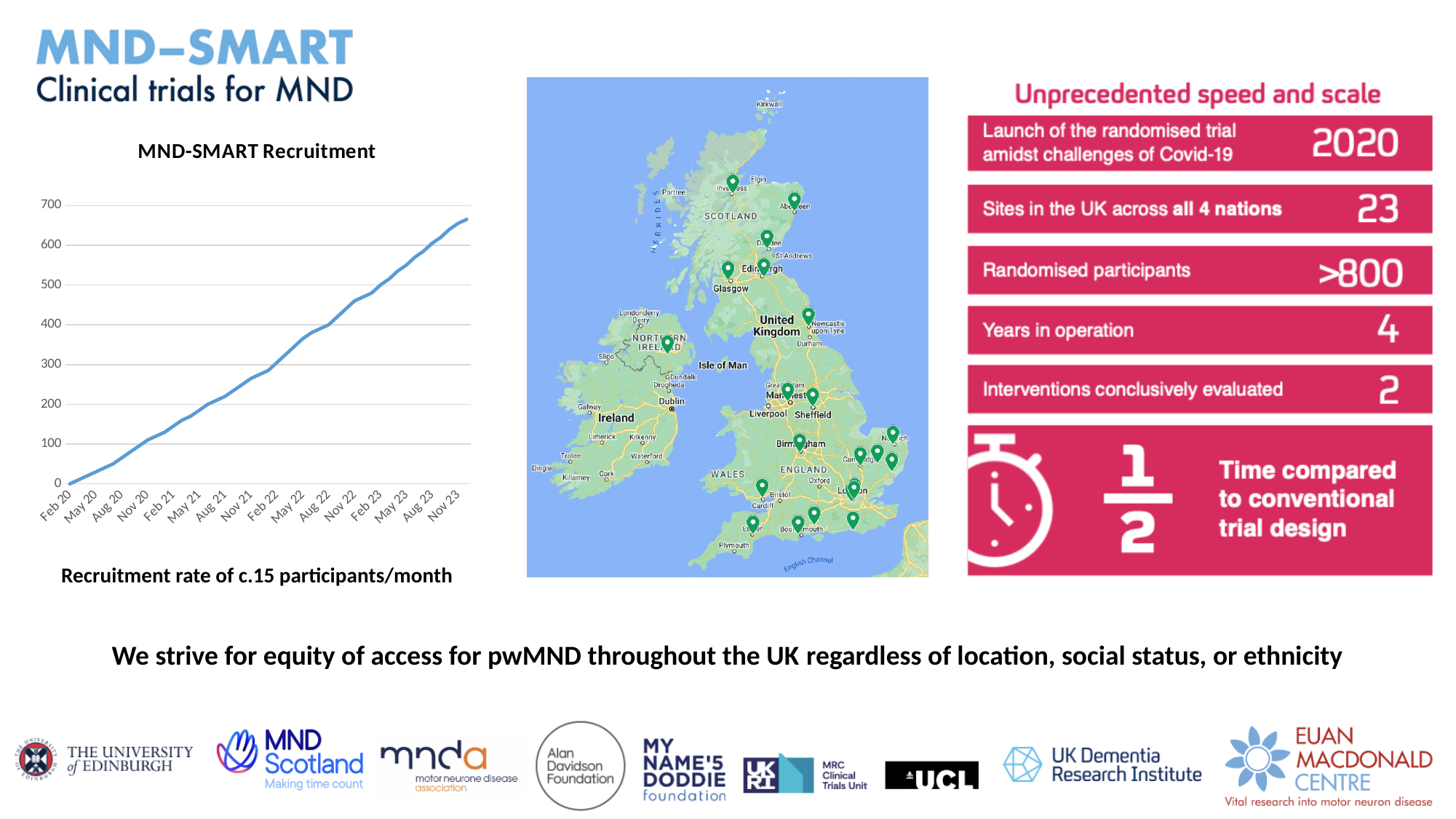
In the MND-SMART Recruitment chart, is the value for Nov 21 greater or less than 300? less In the MND-SMART Recruitment chart, is the value for May 23 greater or less than 500? greater In the MND-SMART Recruitment chart, which x-axis date has the lowest value? Feb 20 In the MND-SMART Recruitment chart, what is the value at Feb 20? 0 In the MND-SMART Recruitment chart, which x-axis date has the highest value? Nov 23 In the MND-SMART Recruitment chart, do the values rise or fall from Feb 20 to Nov 23? rise How many date labels are shown on the x axis of the MND-SMART Recruitment chart? 16 In the MND-SMART Recruitment chart, which is larger, the value for Aug 23 or the value for Feb 21? Aug 23 In the MND-SMART Recruitment chart, is the value for Nov 23 greater or less than 600? greater What kind of chart is the MND-SMART Recruitment chart? line chart What is the title of the chart on the left of the slide? MND-SMART Recruitment